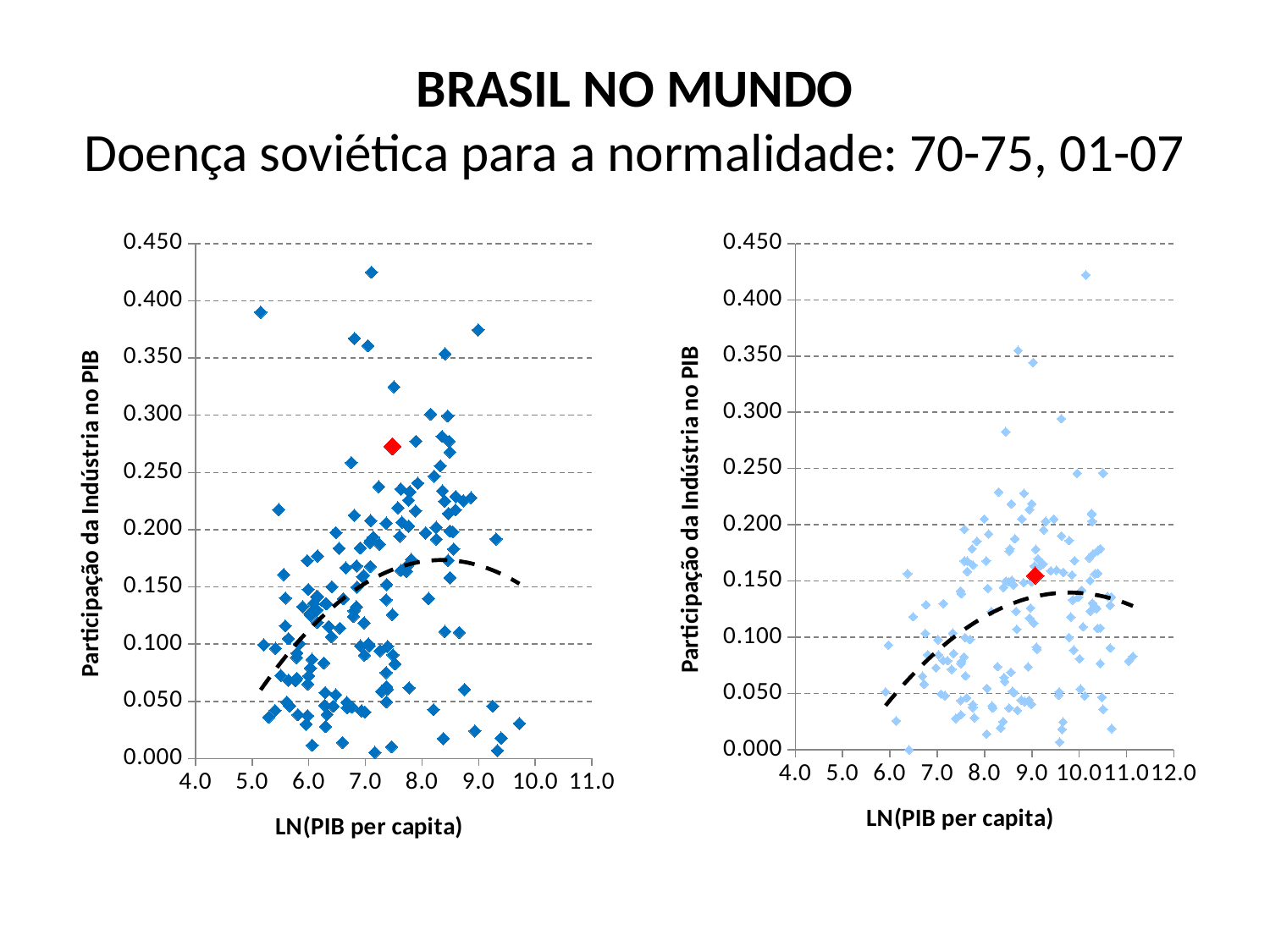
On the left chart, is the value of the red highlighted point greater or less than 0.300? less What is the highest value shown on the y axis of the right chart? 0.450 How many charts are shown on the slide? 2 On the right chart, is the value of the red highlighted point greater or less than 0.100? greater What kind of chart is the right chart on the slide? scatter chart On the right chart, is the value of the red highlighted point greater or less than 0.200? less What kind of chart is the left chart on the slide? scatter chart What is the title of the y axis on the right chart? Participação da Indústria no PIB On the left chart, does the dashed trend line rise or fall as the x axis goes from 5.0 to 8.0? rise What is the title of the x axis on the left chart? LN(PIB per capita) Which chart shows the red highlighted point at a higher value on the y axis, the left chart or the right chart? the left chart